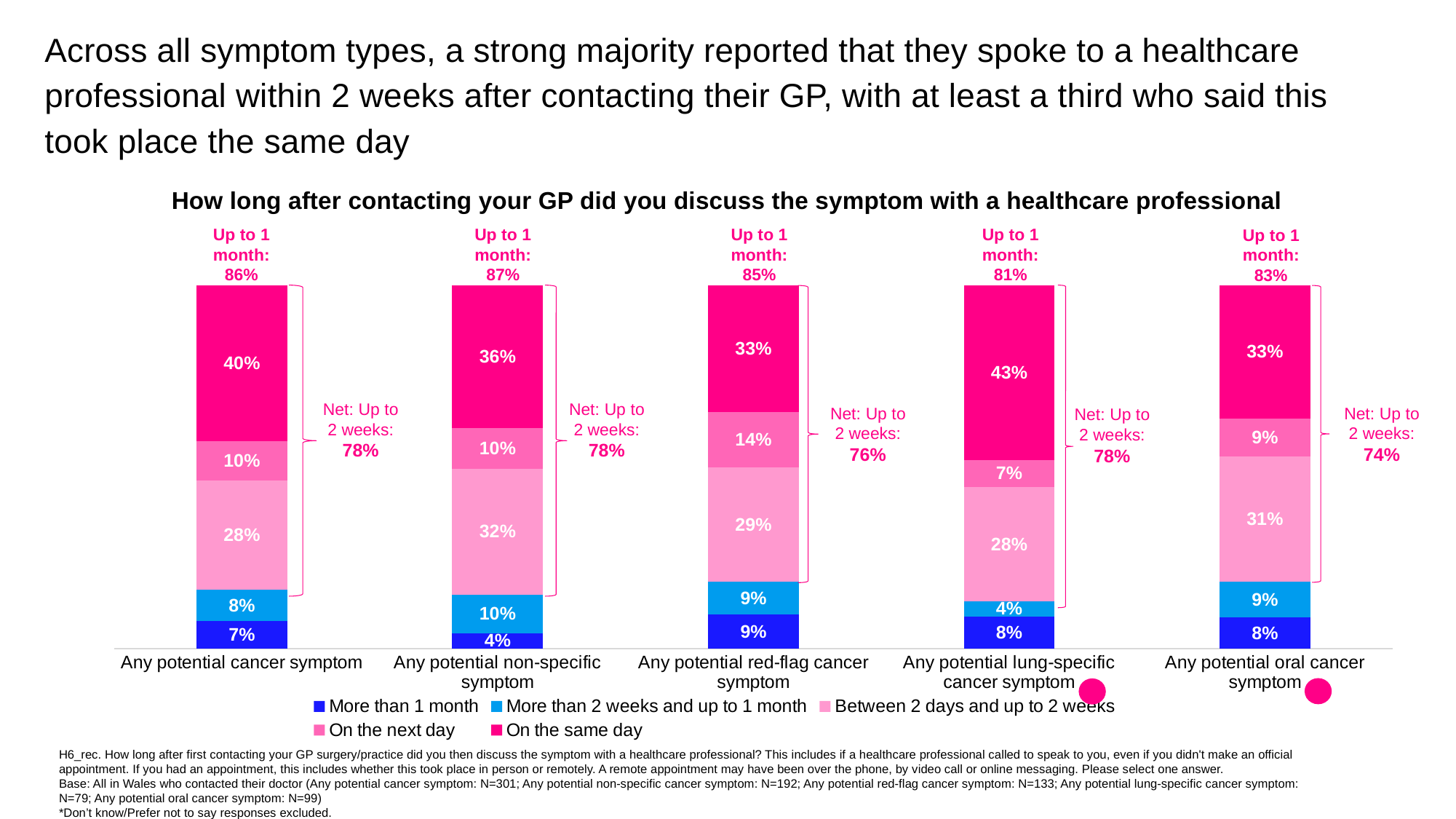
What is the 'Up to 1 month' figure for any potential non-specific symptom? 87% How many symptom categories are shown on the chart? 5 What percentage of respondents with any potential red-flag cancer symptom discussed the symptom on the next day? 14% What kind of chart is shown on the slide? Stacked bar chart What is the difference in the 'On the same day' percentage between any potential cancer symptom and any potential red-flag cancer symptom? 7 percentage points What percentage of respondents with any potential lung-specific cancer symptom discussed the symptom on the same day? 43% Which has the larger 'Between 2 days and up to 2 weeks' percentage: any potential non-specific symptom or any potential lung-specific cancer symptom? Any potential non-specific symptom Which symptom category has the highest 'On the same day' percentage? Any potential lung-specific cancer symptom Which symptom category has the lowest 'More than 1 month' percentage? Any potential non-specific symptom How many series does the legend list? 5 What is the title of the chart? How long after contacting your GP did you discuss the symptom with a healthcare professional What is the Net: Up to 2 weeks figure for any potential oral cancer symptom? 74%